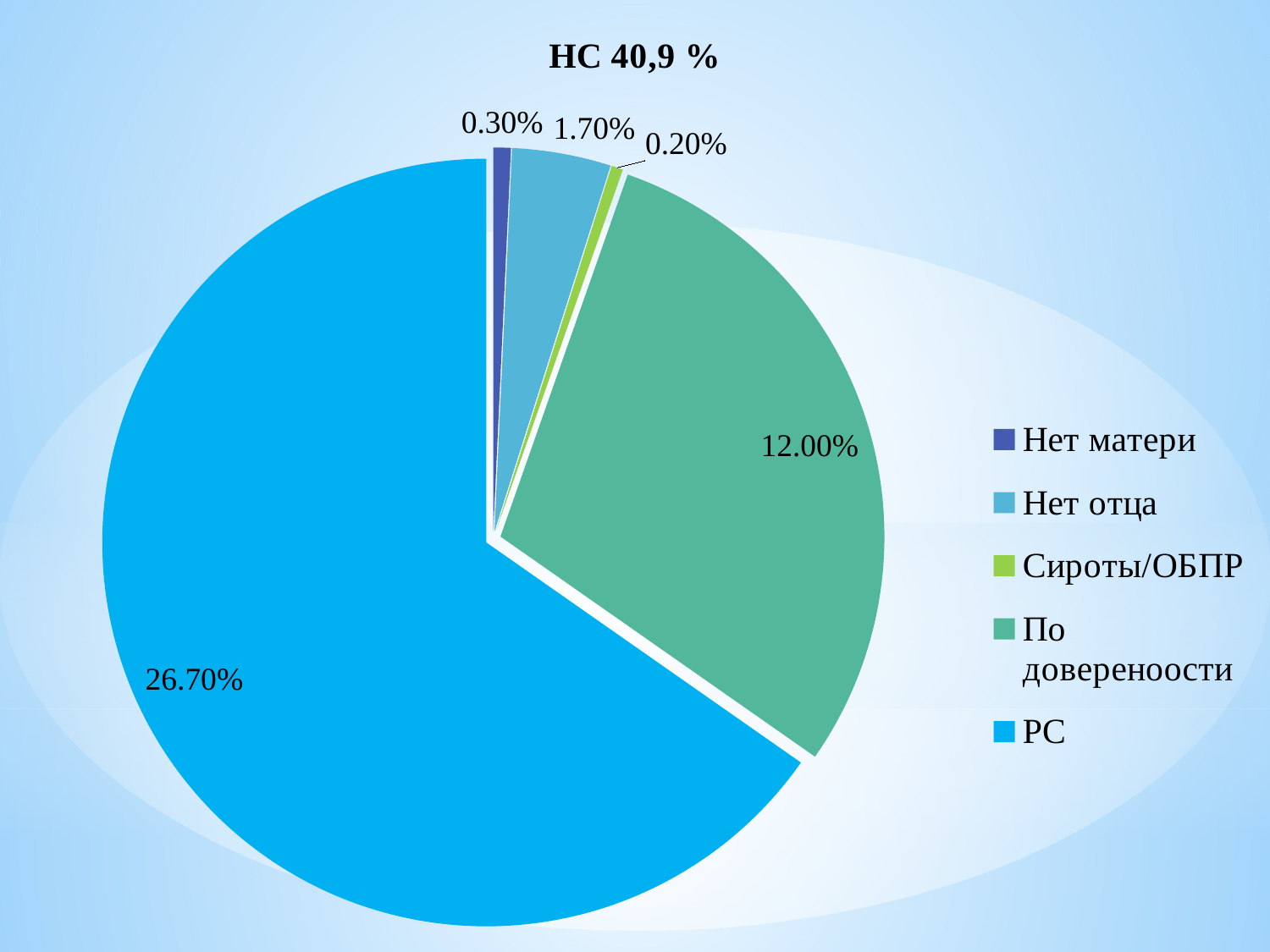
Which category has the largest slice of the pie? РС What value is shown for the Нет матери slice? 0.30% Which is larger, the value for Нет отца or the value for Нет матери? Нет отца How many categories does the legend list? 5 What is the title of the chart? НС 40,9 % What value is shown for the По довереноости slice? 12.00% What type of chart is shown on the slide? pie chart What is the difference between the values for РС and По довереноости? 14.70% What value is shown for the РС slice? 26.70% What value is shown for the Сироты/ОБПР slice? 0.20% Which category has the smallest slice of the pie? Сироты/ОБПР What value is shown for the Нет отца slice? 1.70%